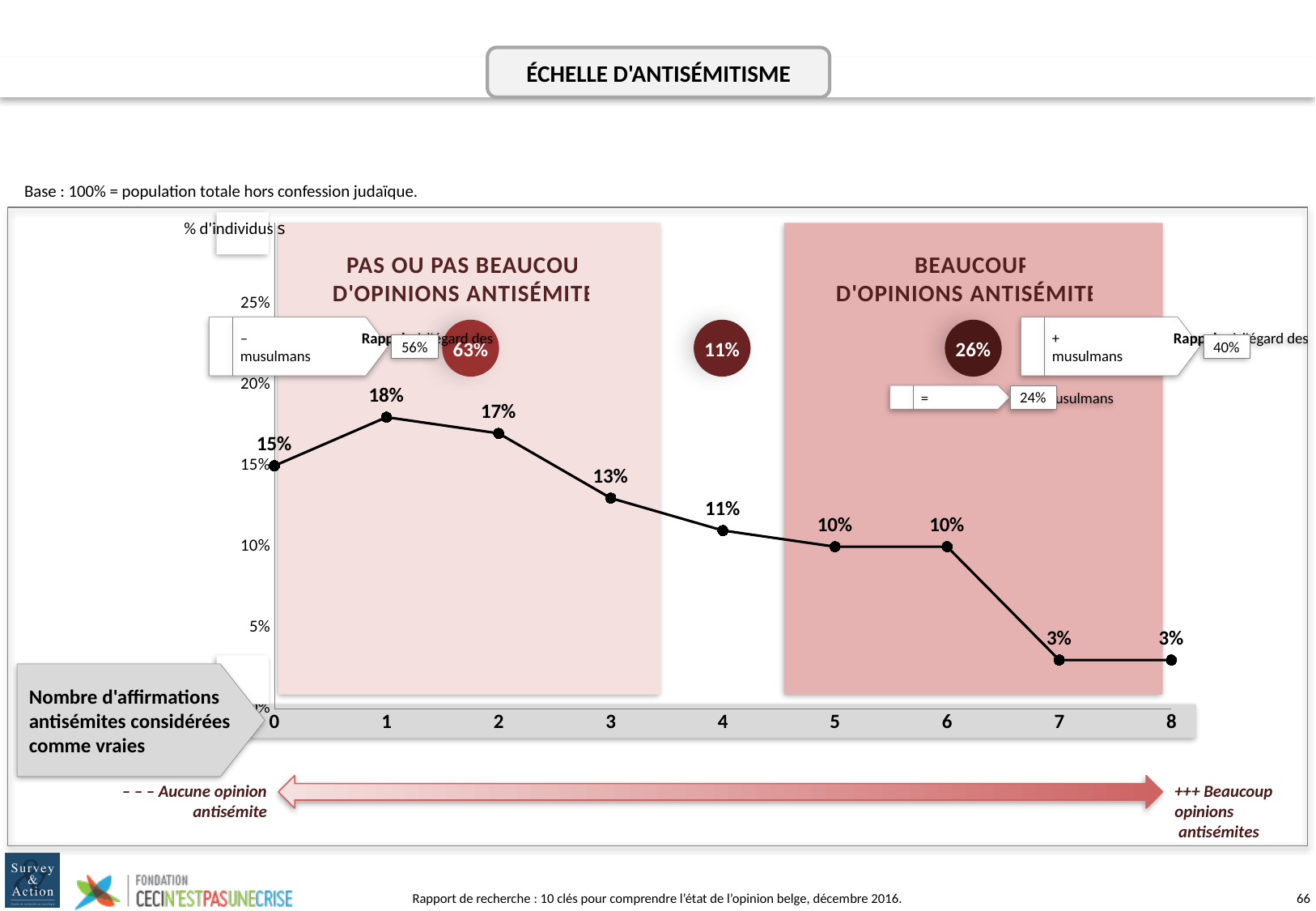
Which is larger, the value for 2 statements or the value for 4 statements? 2 statements What kind of chart is shown on the slide? Line chart What is the difference between the values for 6 and 7 antisemitic statements considered true? 7% What is the lowest percentage value plotted on the line? 3% What is the value for 3 antisemitic statements considered true? 13% What is the value plotted for 0 antisemitic statements considered true? 15% Which number of antisemitic statements considered true has the highest percentage of individuals? 1 What is the difference between the values for 1 and 2 antisemitic statements considered true? 1% From 1 to 8 antisemitic statements considered true, do the plotted values generally rise or fall? Fall How many data points are plotted on the line? 9 What percentage of individuals is shown for 7 antisemitic statements considered true? 3% What percentage of individuals considered 1 antisemitic statement as true? 18%